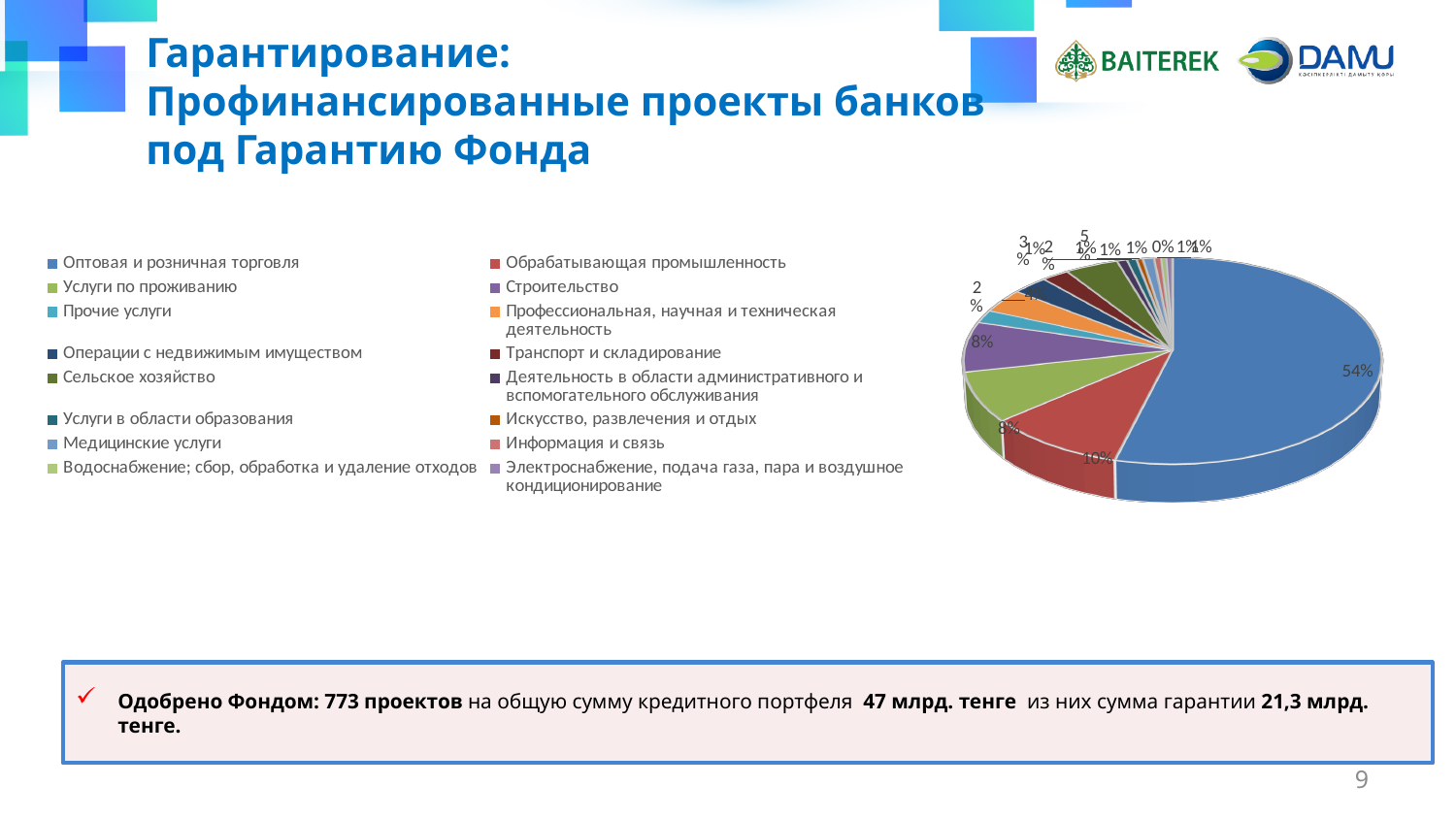
What is the first legend entry listed in the left column? Оптовая и розничная торговля Which is larger: the share for Оптовая и розничная торговля or for Обрабатывающая промышленность? Оптовая и розничная торговля Which category has the largest share of the pie? Оптовая и розничная торговля Is the share for Оптовая и розничная торговля greater or less than 50%? greater What is the difference in percentage points between the 54% slice and the 10% slice? 44 percentage points What colour is the largest slice of the pie? Blue How many categories does the legend list? 16 What share of the pie does the largest slice (Оптовая и розничная торговля) have? 54% What kind of chart is shown on the slide? Pie chart What percentage is shown for the red slice (Обрабатывающая промышленность)? 10%